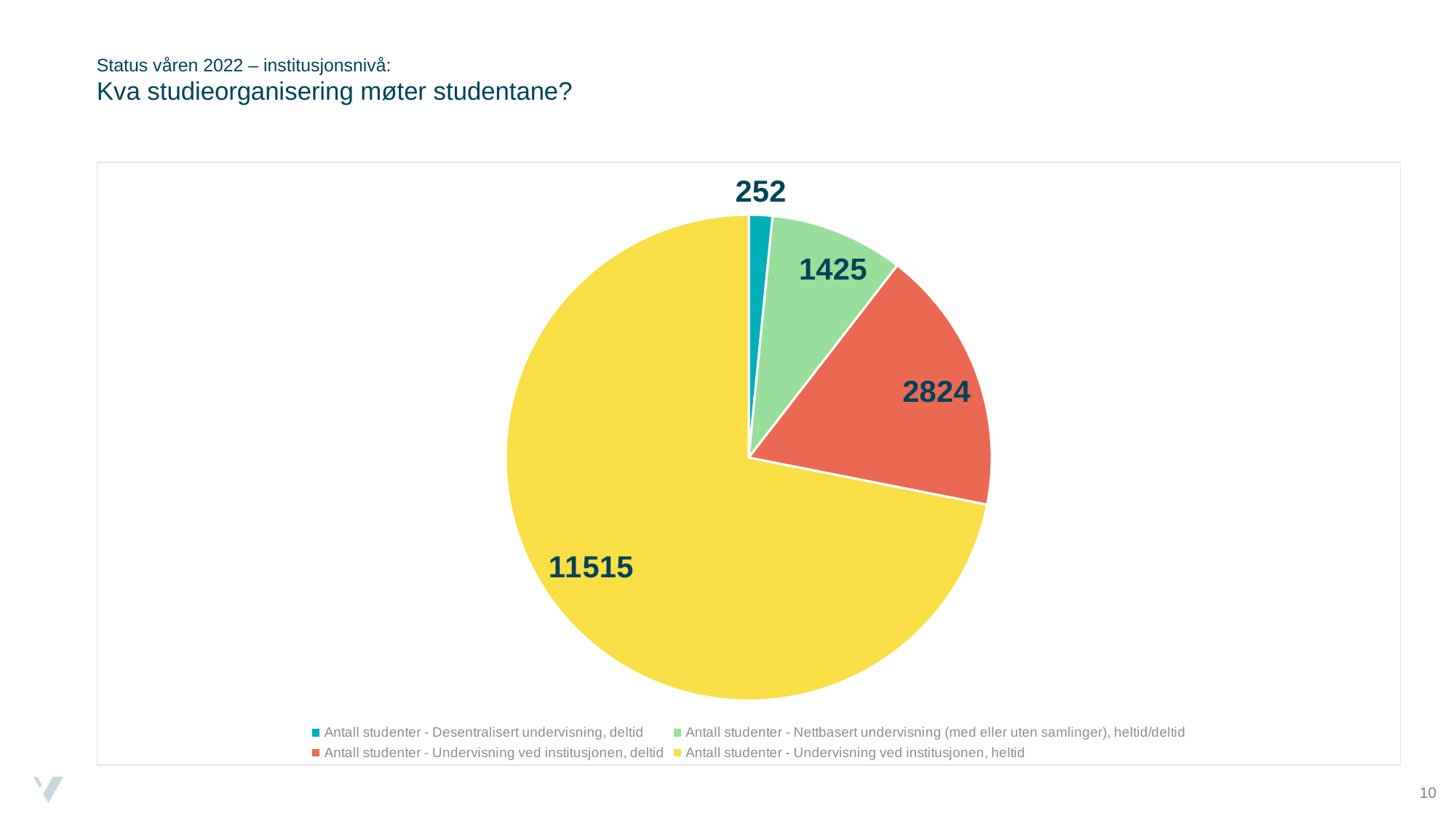
What is the difference between the values for 'Undervisning ved institusjonen, deltid' and 'Nettbasert undervisning'? 1399 What colour is the slice for 'Antall studenter - Undervisning ved institusjonen, heltid'? Yellow How many entries does the legend list? 4 What is the value for 'Antall studenter - Undervisning ved institusjonen, heltid'? 11515 What is the value for 'Antall studenter - Undervisning ved institusjonen, deltid'? 2824 Which is larger: the value for 'Nettbasert undervisning' or the value for 'Desentralisert undervisning, deltid'? Nettbasert undervisning What is the value for 'Antall studenter - Nettbasert undervisning (med eller uten samlinger), heltid/deltid'? 1425 How many slices does the pie chart have? 4 What type of chart is shown on the slide? Pie chart What is the value for 'Antall studenter - Desentralisert undervisning, deltid'? 252 Which category has the smallest slice of the pie? Antall studenter - Desentralisert undervisning, deltid Which category has the largest slice of the pie? Antall studenter - Undervisning ved institusjonen, heltid